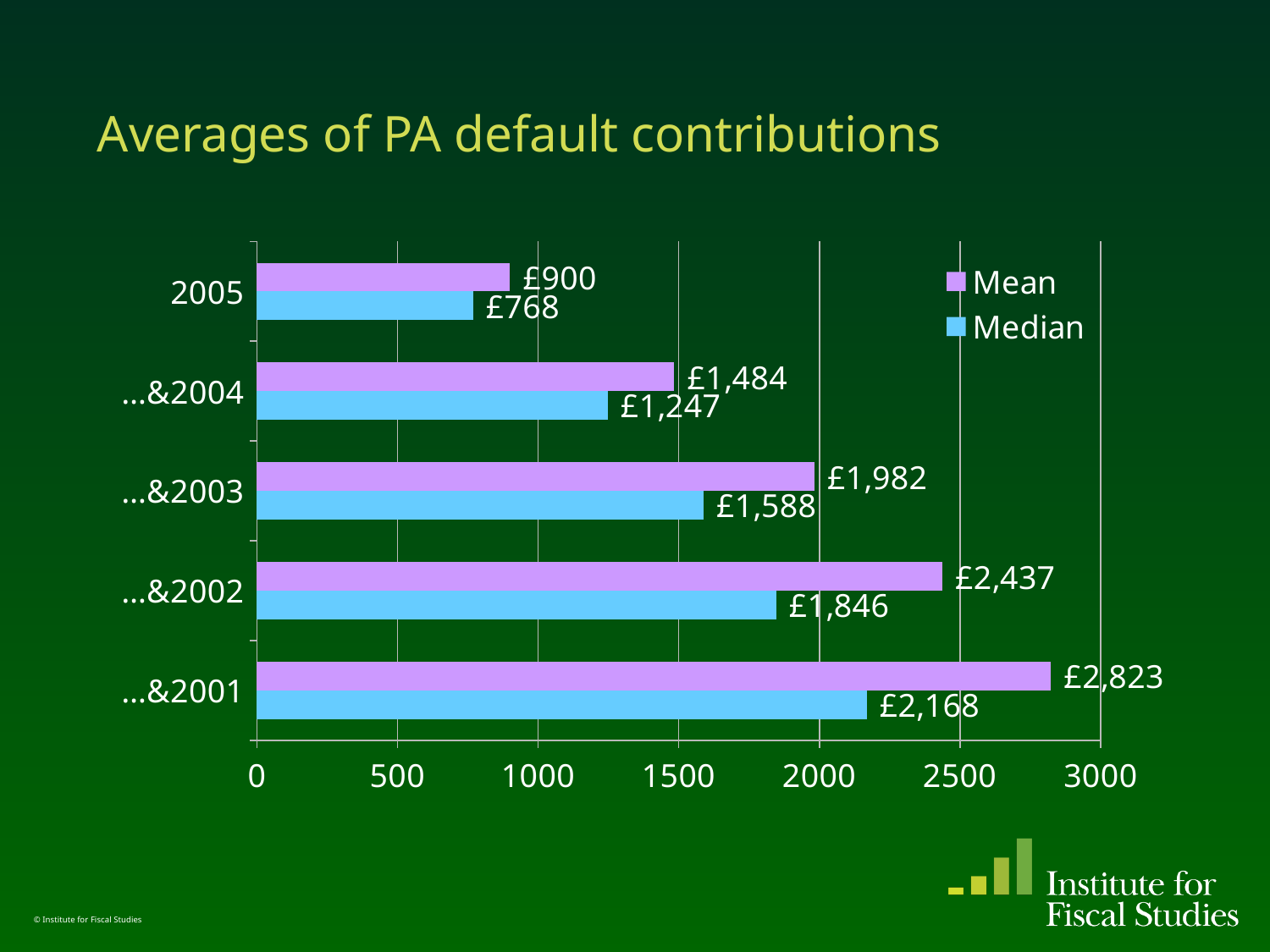
Is the Median value for …&2001 greater or less than 2000? greater What is the Median value for …&2003? £1,588 What is the Mean value for 2005? £900 What kind of chart is shown on the slide? Bar chart What is the title of the chart? Averages of PA default contributions How many categories are shown on the chart? 5 Which category has the highest Median value? …&2001 Which is larger, the Mean for …&2004 or the Median for …&2003? Median for …&2003 How many series does the legend list? 2 What is the Mean value for …&2001? £2,823 Which category has the lowest Mean value? 2005 What is the difference between the Mean and Median values for …&2002? £591